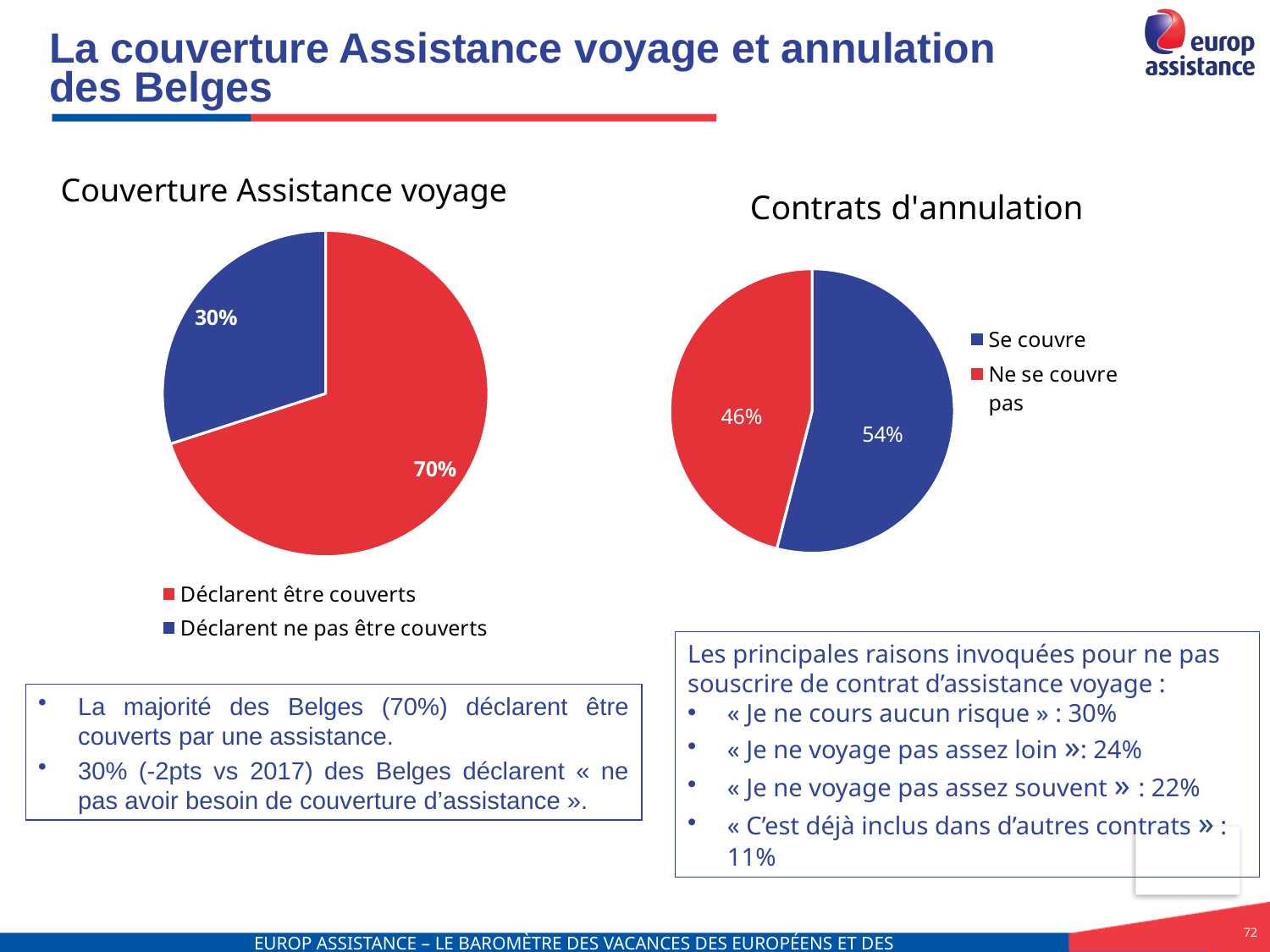
In the 'Couverture Assistance voyage' chart, what share of Belgians 'Déclarent ne pas être couverts'? 30% In the 'Couverture Assistance voyage' chart, which category has the largest slice? Déclarent être couverts In the 'Couverture Assistance voyage' chart, what colour is the 'Déclarent être couverts' slice? Red In the 'Contrats d'annulation' chart, what is the value for 'Ne se couvre pas'? 46% In the 'Couverture Assistance voyage' chart, what is the difference in percentage points between 'Déclarent être couverts' and 'Déclarent ne pas être couverts'? 40 percentage points In the 'Couverture Assistance voyage' chart, what share of Belgians 'Déclarent être couverts'? 70% In the 'Contrats d'annulation' chart, which category has the smallest slice? Ne se couvre pas In the 'Contrats d'annulation' chart, what is the value for 'Se couvre'? 54% How many slices does the 'Contrats d'annulation' chart have? 2 In the 'Contrats d'annulation' chart, which is larger: 'Se couvre' or 'Ne se couvre pas'? Se couvre What type of chart is 'Couverture Assistance voyage'? Pie chart In the 'Contrats d'annulation' chart, what is the difference in percentage points between 'Se couvre' and 'Ne se couvre pas'? 8 percentage points